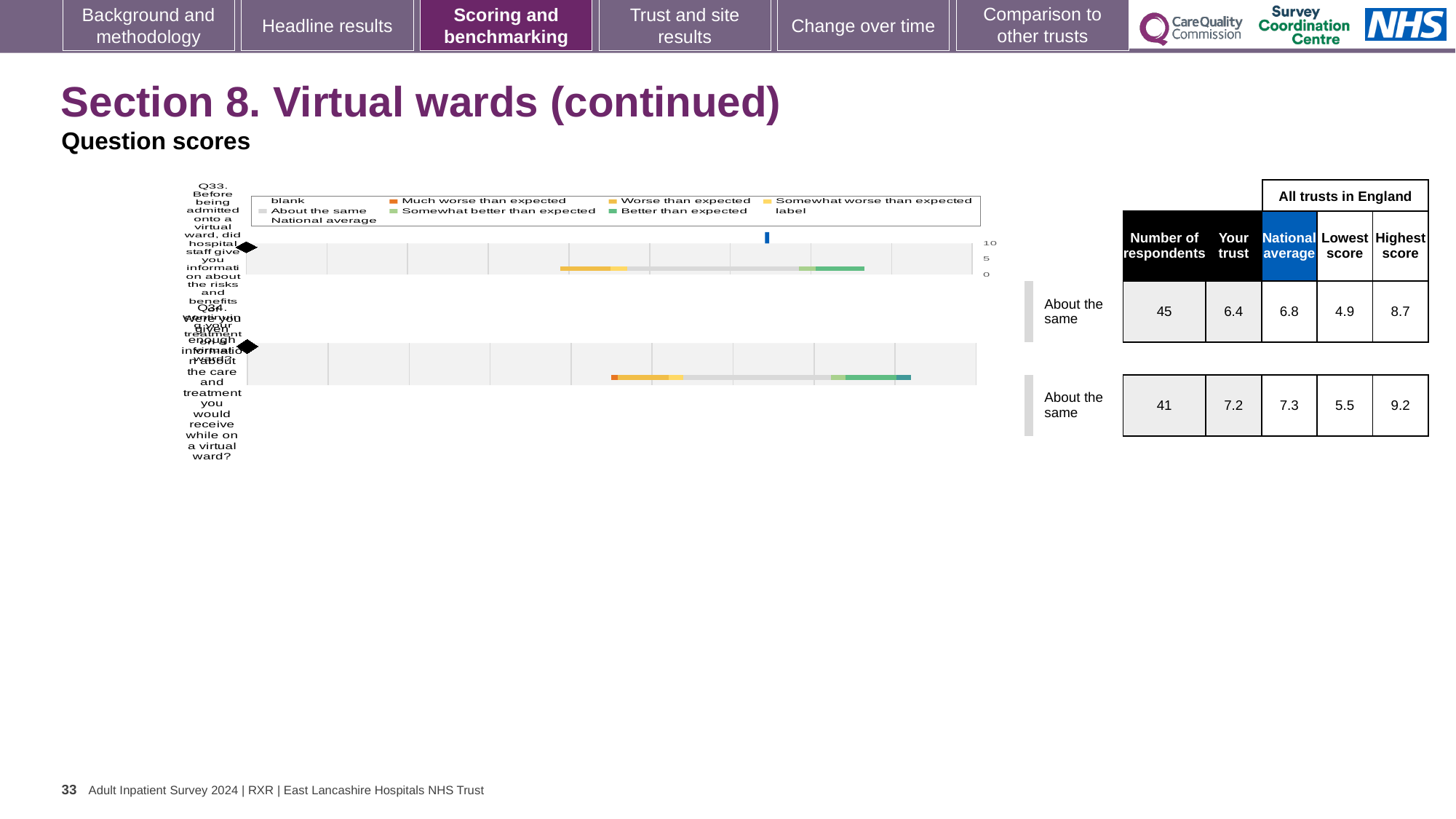
How many respondents are shown for Q33 in the table? 45 What is the 'Your trust' score for Q33? 6.4 What is the difference between the national average and the 'Your trust' score for Q33? 0.4 What benchmark category is shown next to both Q33 and Q34? About the same Which is larger for Q34: the 'Your trust' score or the national average? national average Which legend entry is shown in dark green? Better than expected What is the lowest score among all trusts in England for Q34? 5.5 What kind of chart is used to show the question scores for Q33 and Q34? bar chart How many respondents are shown for Q34? 41 What is the highest score among all trusts in England for Q33? 8.7 What is the 'Your trust' score for Q34? 7.2 What is the national average score for Q33? 6.8